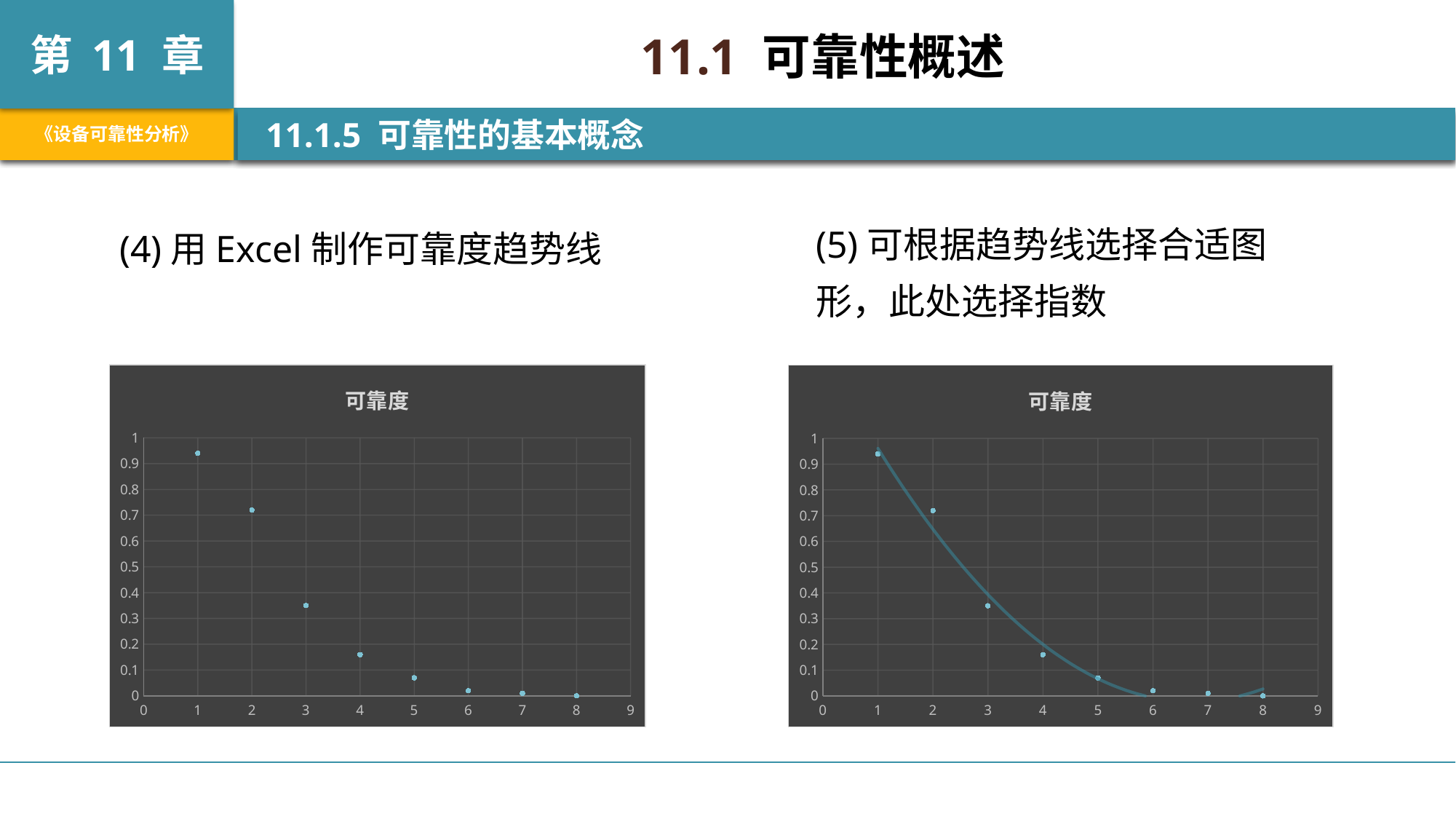
In the left chart titled 可靠度, is the value at x = 1 greater or less than 0.9? greater How many data points are plotted in the left chart titled 可靠度? 8 In the right chart titled 可靠度, do the plotted values rise or fall as x increases? fall In the left chart titled 可靠度, is the value at x = 3 greater or less than 0.4? less Which chart on the slide, left or right, includes a fitted trendline through the points? right In the right chart titled 可靠度, is the value at x = 5 greater or less than 0.1? less In the left chart titled 可靠度, at which x value is the plotted value highest? 1 What is the title of the right chart? 可靠度 What kind of chart is the left chart titled 可靠度? scatter chart In the left chart titled 可靠度, which is larger, the value at x = 2 or the value at x = 4? x = 2